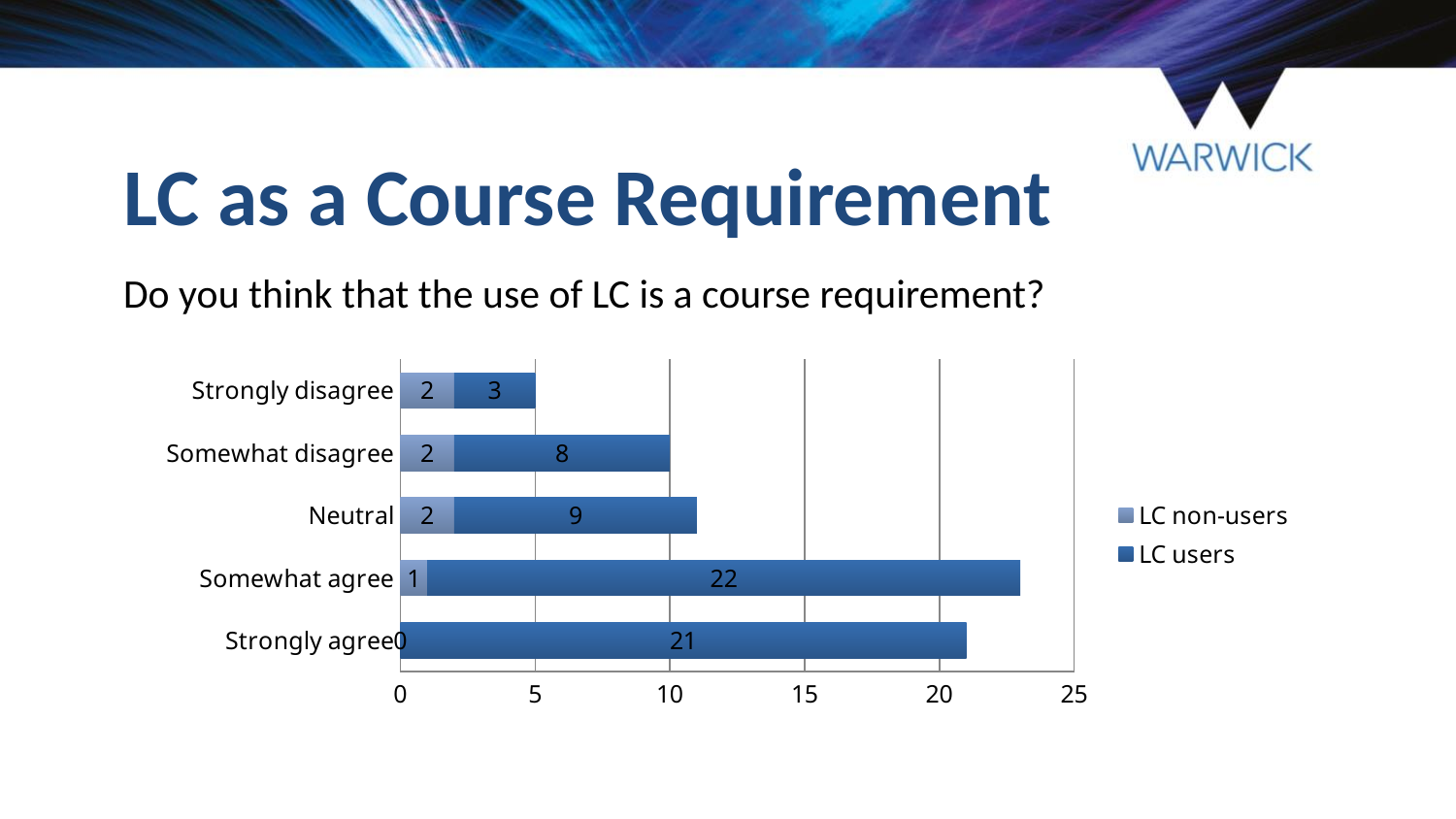
What is the value for LC users in the Somewhat agree category? 22 Which category has the lowest value for LC users? Strongly disagree How many response categories are shown on the chart? 5 What is the value for LC users in the Strongly disagree category? 3 What kind of chart is shown on the slide? bar chart What is the difference between the LC users values for Somewhat agree and Strongly agree? 1 What is the value for LC non-users in the Neutral category? 2 How many series does the legend list? 2 What is the total of the stacked bar for Neutral? 11 Which category has the highest value for LC users? Somewhat agree Which series is shown in the darker blue colour? LC users Which is larger for LC users: Somewhat disagree or Neutral? Neutral